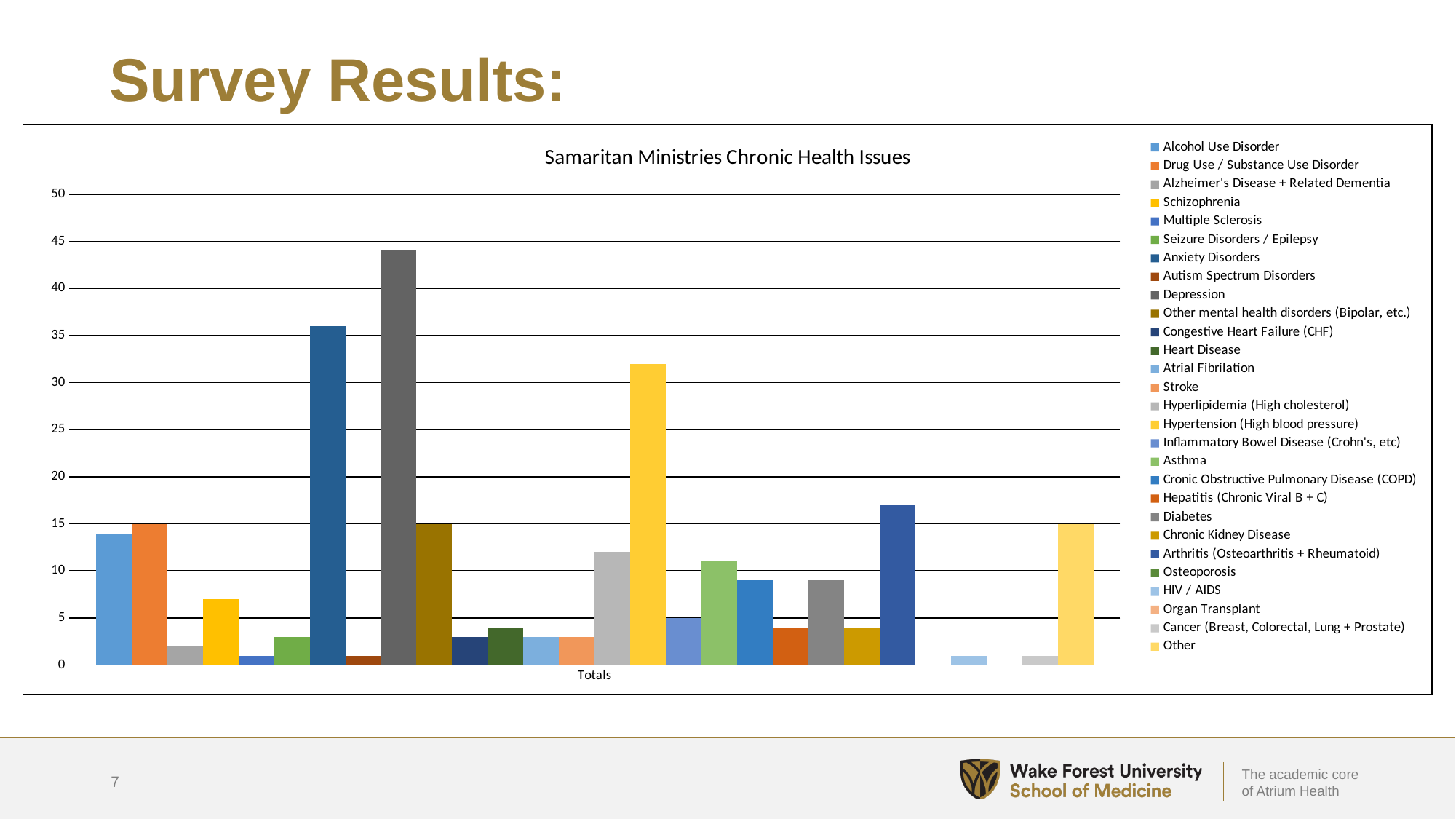
Is the value for Anxiety Disorders greater or less than 30? greater How many categories are shown on the x axis? 1 What type of chart is shown on the slide? Bar chart What is the label of the single category on the x axis? Totals Is the value for Arthritis (Osteoarthritis + Rheumatoid) greater or less than 20? less Is the value for Hypertension (High blood pressure) greater or less than 25? greater How many series does the legend list? 28 Which series has the highest bar? Depression Which is larger, the value for Depression or the value for Anxiety Disorders? Depression Which is larger, the value for Hypertension (High blood pressure) or the value for Arthritis (Osteoarthritis + Rheumatoid)? Hypertension (High blood pressure) What is the title of the chart? Samaritan Ministries Chronic Health Issues